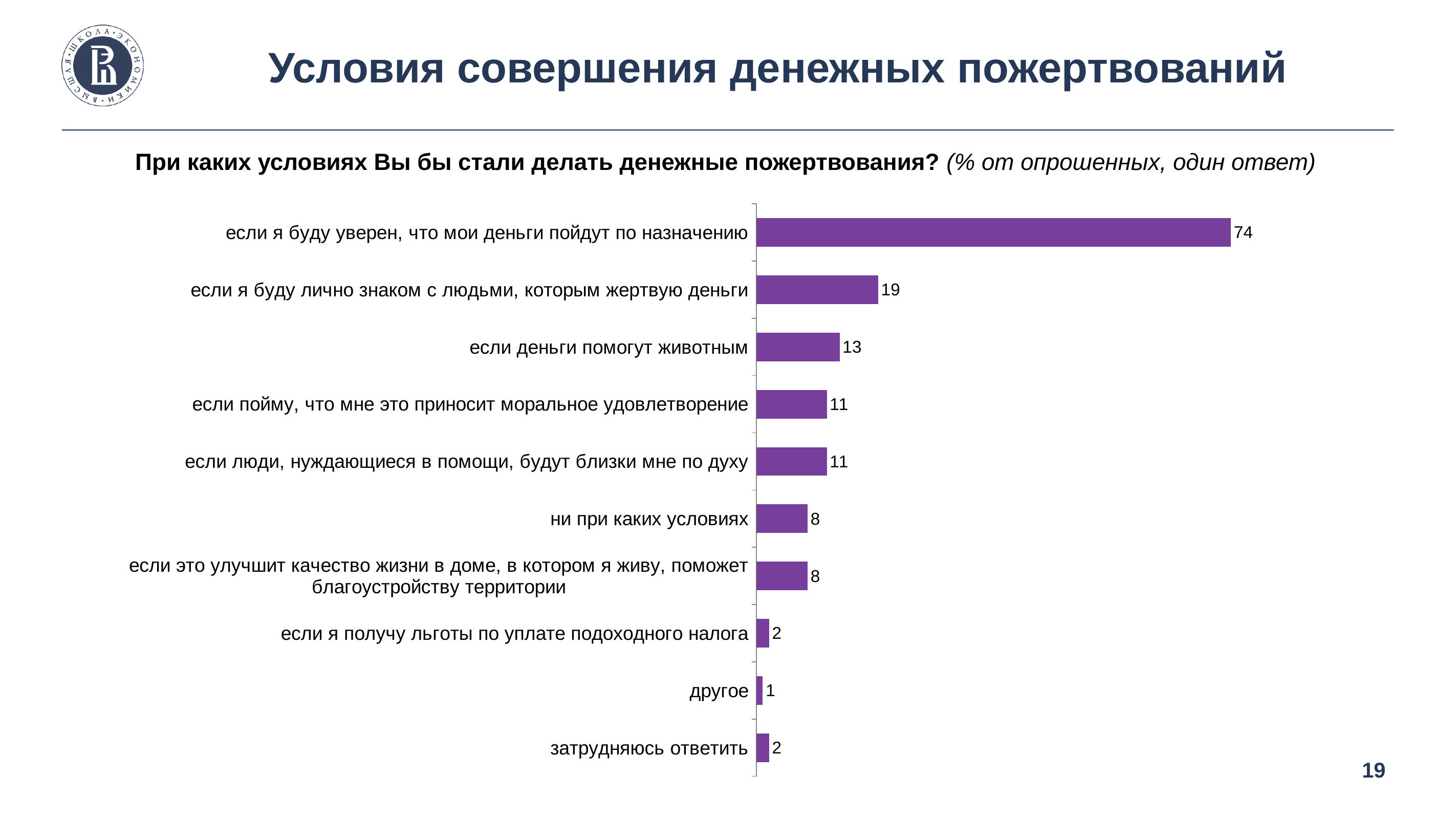
Which category has the lowest value on the chart? другое What colour are the bars on the chart? purple What is the value for "если деньги помогут животным"? 13 What percentage of respondents would donate money if they were sure their money would go to its intended purpose ("если я буду уверен, что мои деньги пойдут по назначению")? 74 What is the value for "другое"? 1 What is the value for "ни при каких условиях"? 8 What type of chart is shown on the slide? bar chart How many categories are shown on the chart? 10 Which condition has the highest share of respondents? если я буду уверен, что мои деньги пойдут по назначению Which is larger: the value for "если деньги помогут животным" or the value for "ни при каких условиях"? если деньги помогут животным What is the difference between the value for "если я буду уверен, что мои деньги пойдут по назначению" and the value for "если я буду лично знаком с людьми, которым жертвую деньги"? 55 What is the value for "если я буду лично знаком с людьми, которым жертвую деньги"? 19